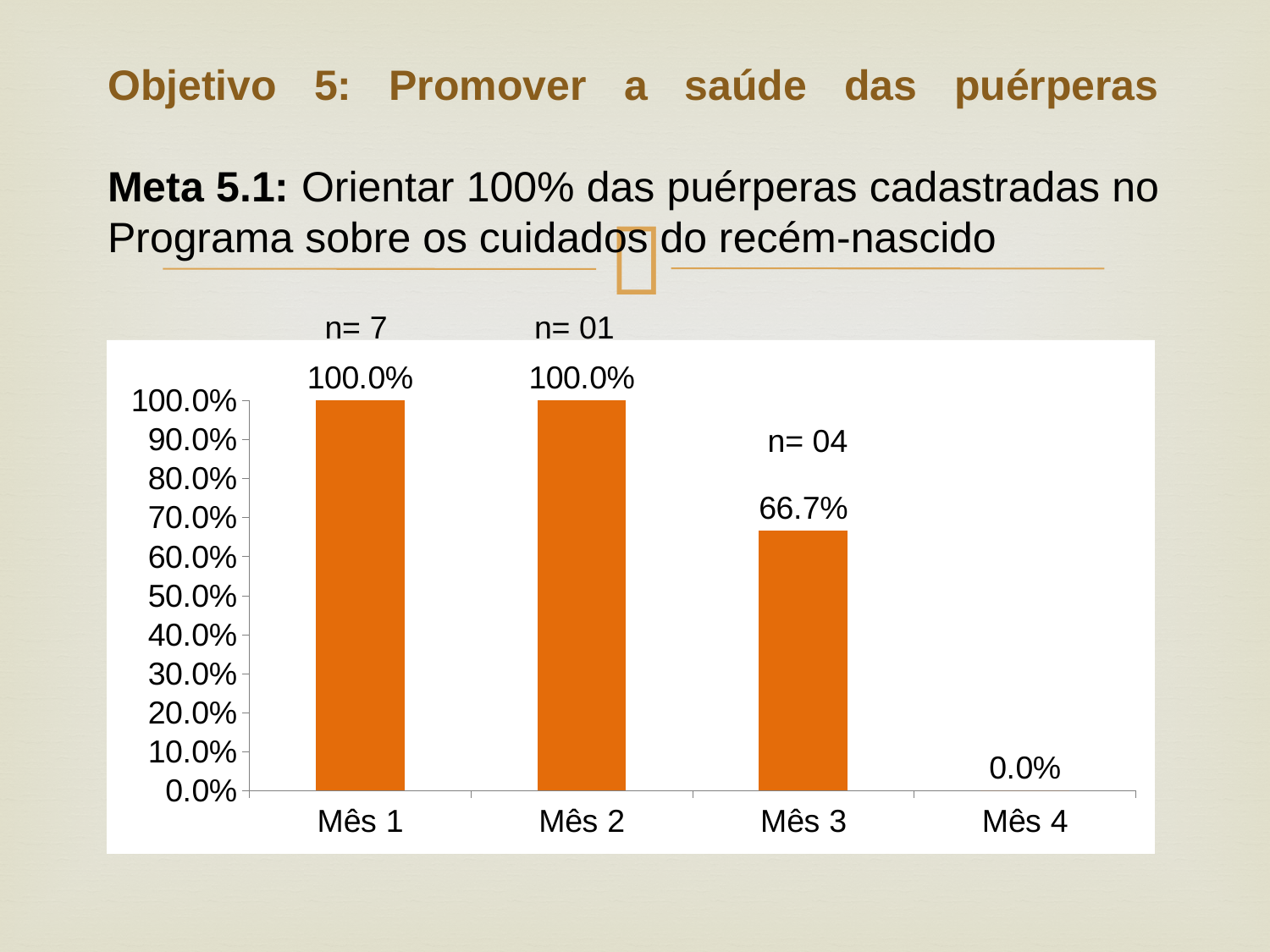
What is the value for Mês 4? 0.0% What is the value for Mês 3? 66.7% What colour are the bars in the chart? orange Do the values rise or fall from Mês 2 to Mês 4? fall Is the value for Mês 3 greater or less than 60.0%? greater What is the value for Mês 1? 100.0% What is the difference between the values for Mês 2 and Mês 3? 33.3% Which is larger, the value for Mês 3 or the value for Mês 4? Mês 3 Which category has the lowest value? Mês 4 What is the n value shown above the bar for Mês 3? n= 04 How many categories are shown on the x axis? 4 What kind of chart is shown on the slide? bar chart